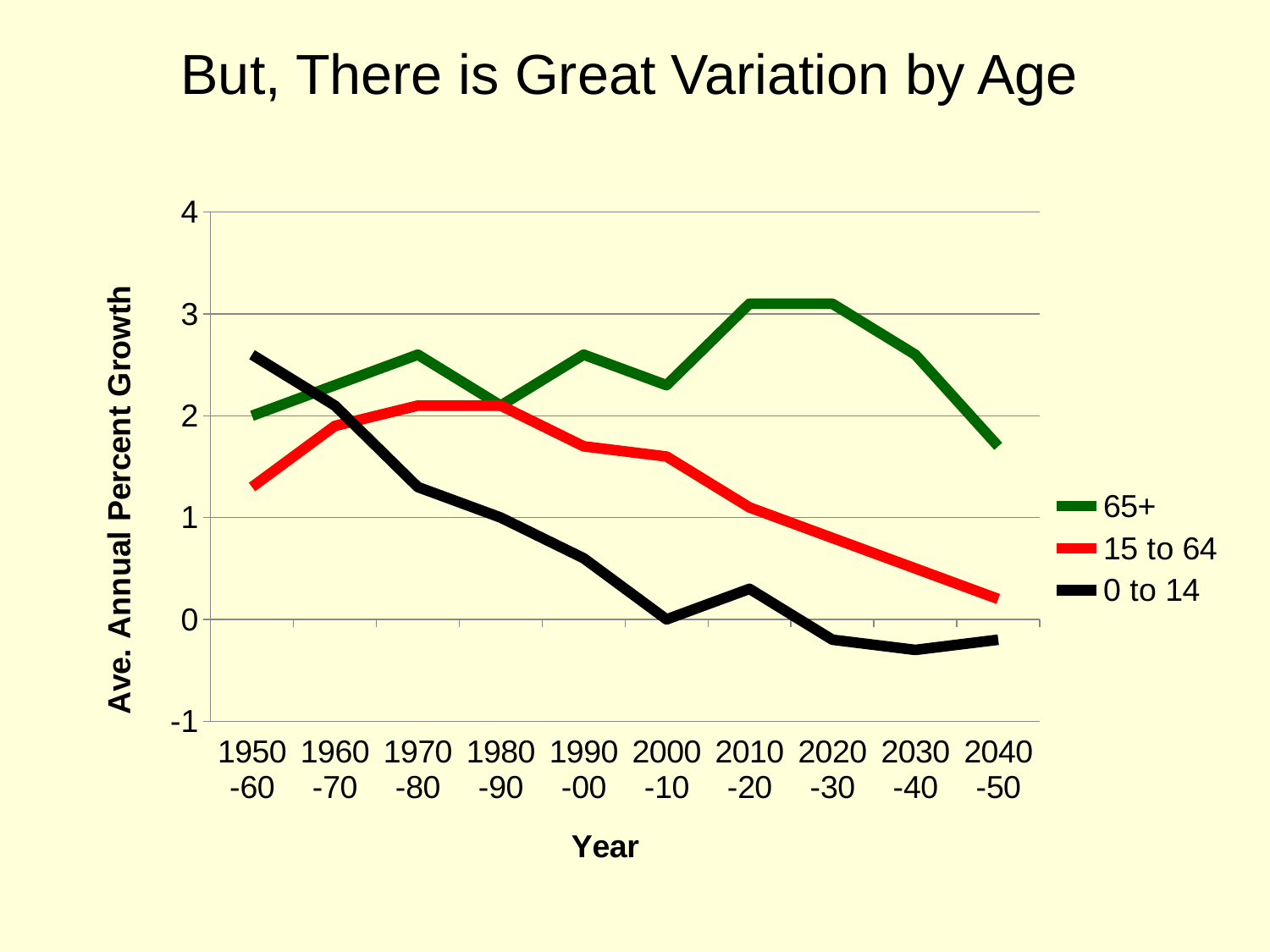
Is the value for 65+ in 2010-20 greater or less than 3? greater Is the value for 15 to 64 in 2040-50 greater or less than 1? less Is the value for 0 to 14 in 2030-40 greater or less than 0? less Which series has the lowest value in the 2040-50 period? 0 to 14 What kind of chart is shown on the slide? line chart Which series has the highest value in the 2010-20 period? 65+ What is the label of the y axis? Ave. Annual Percent Growth How many series does the legend list? 3 Does the 15 to 64 series rise or fall from 1970-80 to 2040-50? fall Which is larger in 1950-60, the value for 0 to 14 or the value for 15 to 64? 0 to 14 How many year periods are shown along the x axis? 10